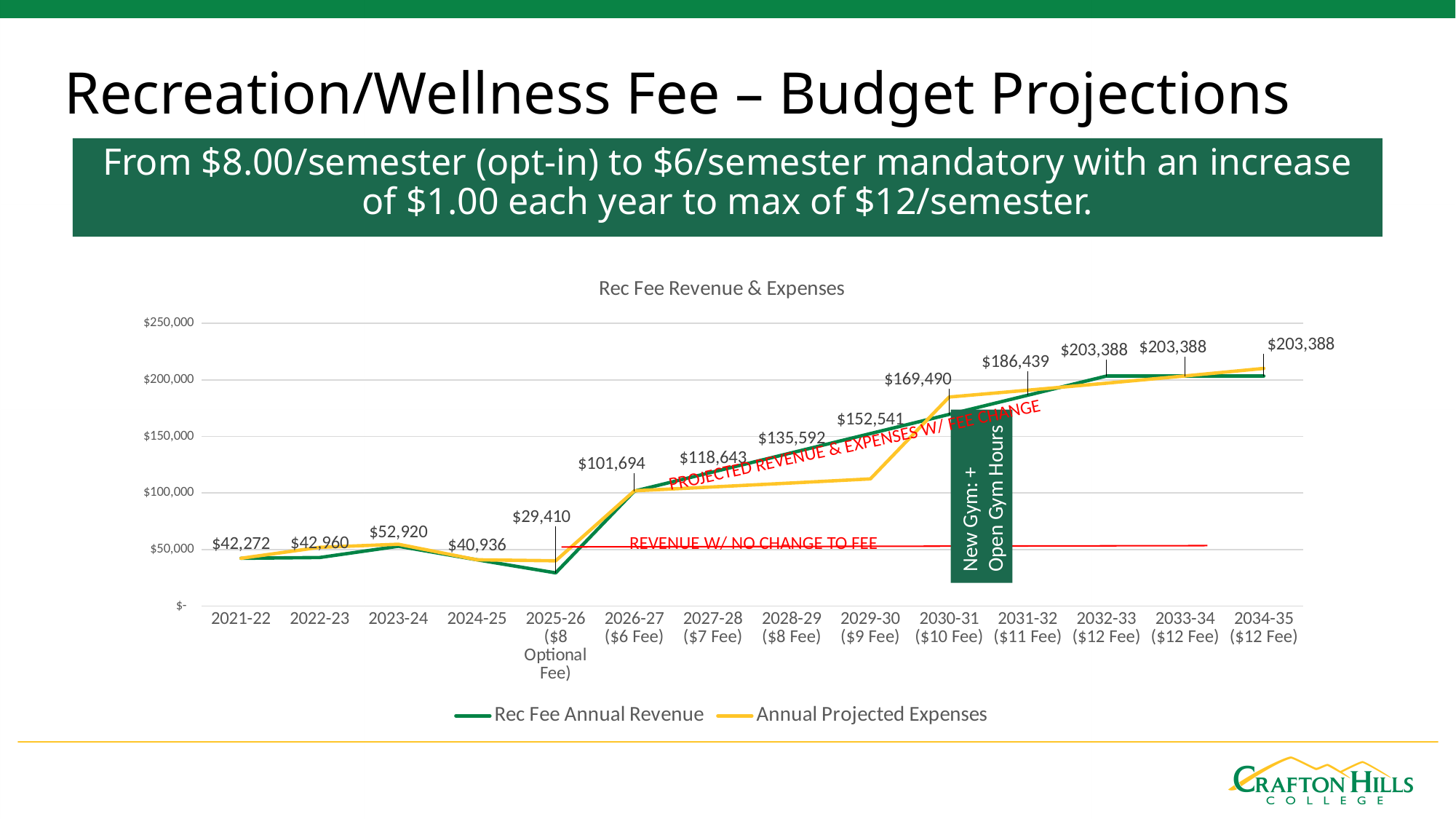
Is the Annual Projected Expenses value for 2029-30 ($9 Fee) greater or less than $150,000? less What is the difference in Rec Fee Annual Revenue between 2023-24 and 2024-25? $11,984 Which year has the higher Rec Fee Annual Revenue, 2022-23 or 2023-24? 2023-24 How many fiscal years are plotted along the x axis of the chart? 14 What is the Rec Fee Annual Revenue for 2030-31 ($10 Fee)? $169,490 What kind of chart is shown on the slide? line chart Which year has the lowest Rec Fee Annual Revenue? 2025-26 ($8 Optional Fee) What is the Rec Fee Annual Revenue for 2026-27 ($6 Fee)? $101,694 Does the Rec Fee Annual Revenue rise or fall from 2026-27 to 2032-33? rise What is the difference in Rec Fee Annual Revenue between 2026-27 ($6 Fee) and 2025-26 ($8 Optional Fee)? $72,284 How many series does the legend of the chart list? 2 What is the Rec Fee Annual Revenue for 2025-26 ($8 Optional Fee)? $29,410